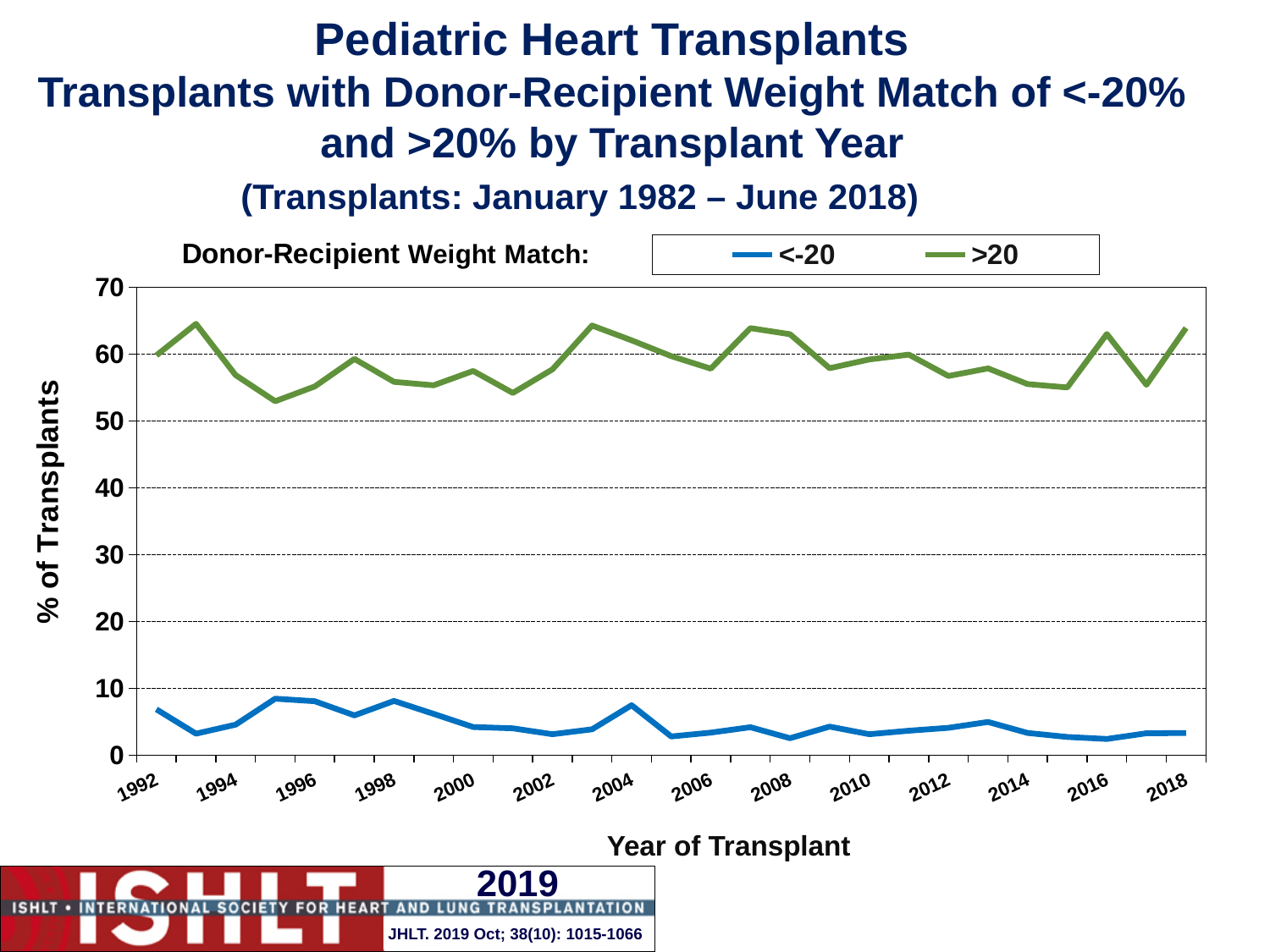
Is the value for the <-20 series in 2004 greater or less than 10? less Is the value for the <-20 series in 2016 greater or less than 10? less In 2010, which series has the larger value, <-20 or >20? >20 Is the value for the >20 series in 1995 greater or less than 60? less What are the two series named in the legend? <-20 and >20 How many series does the legend list? 2 What kind of chart is shown on the slide? line chart How many year labels are printed on the x axis? 14 What is the label of the y axis? % of Transplants Which series has the higher values across all years shown? >20